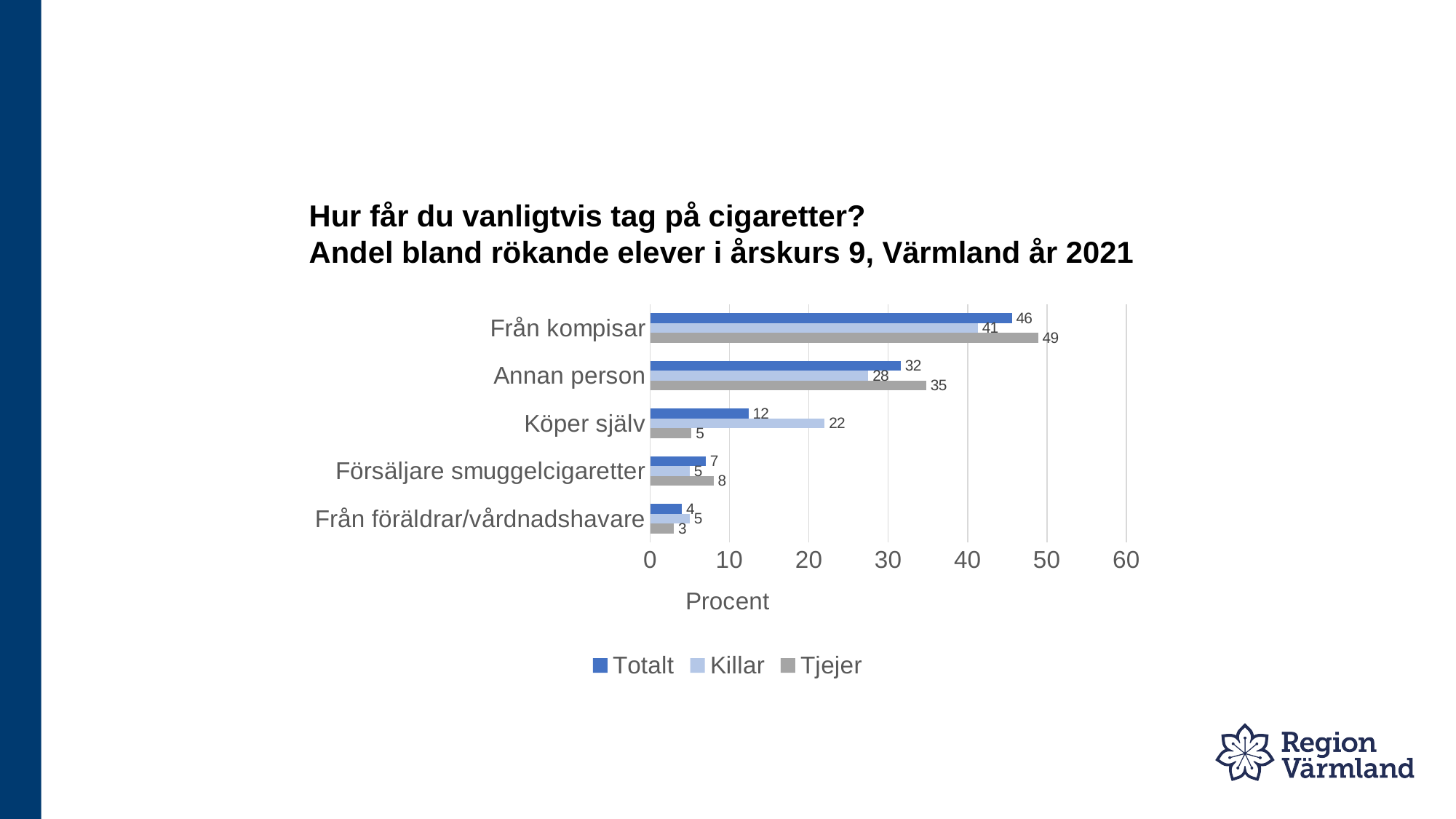
For Köper själv, which is larger: the Killar value or the Tjejer value? Killar Is the Totalt value for Annan person greater or less than 30? greater What is the Tjejer value for Annan person? 35 How many series does the legend list? 3 Which category has the lowest Totalt value? Från föräldrar/vårdnadshavare What is the Killar value for Köper själv? 22 What kind of chart is shown on the slide? Bar chart What is the label of the x axis? Procent How many categories are shown on the y axis? 5 Which category has the highest Tjejer value? Från kompisar What is the Totalt value for Från kompisar? 46 What is the difference between the Tjejer and Killar values for Från kompisar? 8